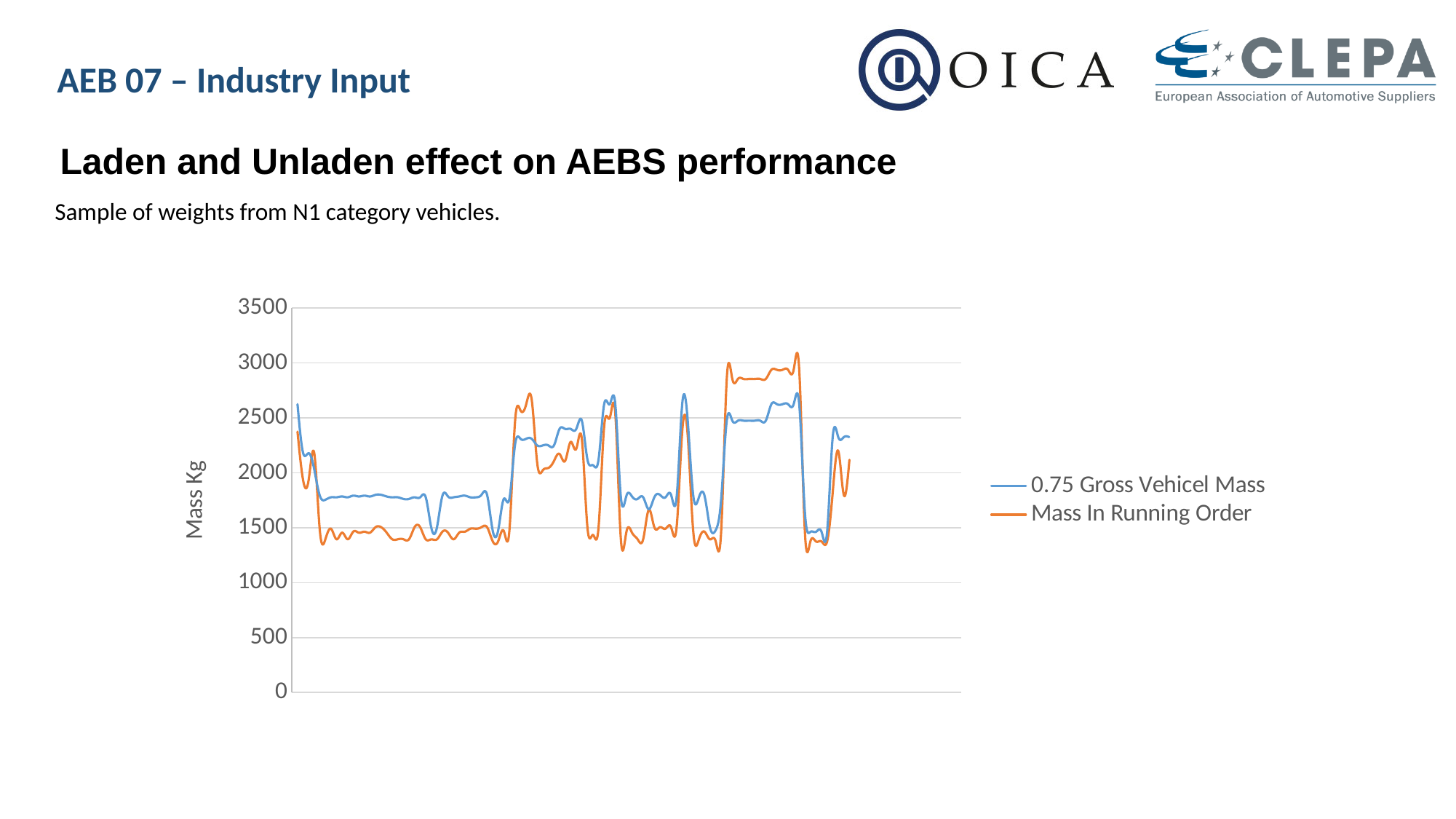
What is the label on the vertical axis of the chart? Mass Kg Is the lowest value of the 0.75 Gross Vehicel Mass series greater or less than 1000? greater Is the highest value of the 0.75 Gross Vehicel Mass series greater or less than 3000? less Is the highest value of the 0.75 Gross Vehicel Mass series greater or less than 2500? greater What kind of chart is shown on the slide? Line chart How many series does the chart legend list? 2 Which colour is used for the Mass In Running Order series? Orange